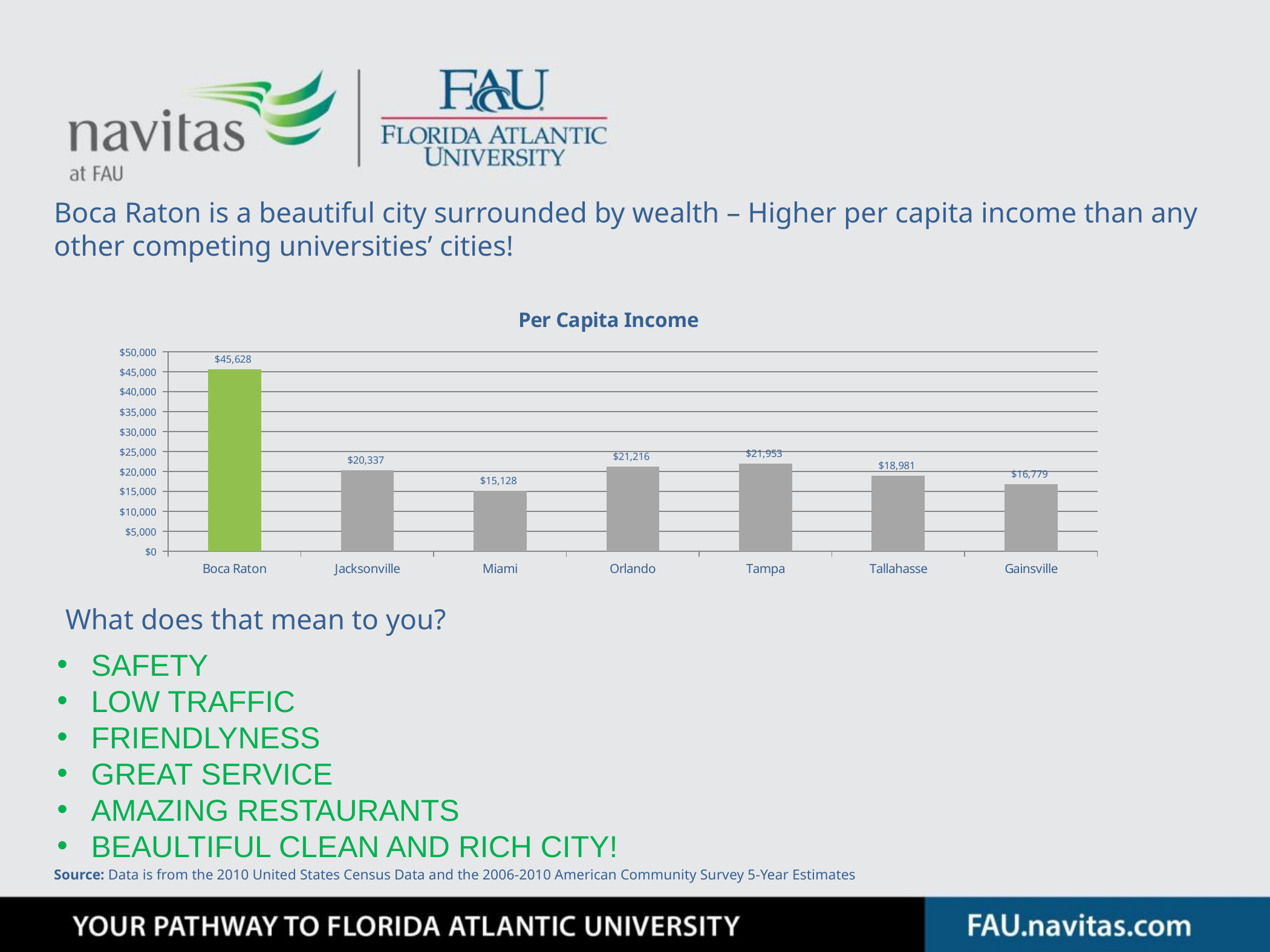
What is the per capita income shown for Miami? $15,128 Which city has the lowest per capita income in the chart? Miami How many cities are shown in the Per Capita Income chart? 7 Which bar in the chart is coloured green rather than grey? Boca Raton Which city has the highest per capita income in the chart? Boca Raton What type of chart is used to show Per Capita Income? bar chart What is the difference in per capita income between Boca Raton and Jacksonville? $25,291 What is the per capita income shown for Tallahasse? $18,981 What is the difference in per capita income between Tallahasse and Gainsville? $2,202 Is the per capita income for Gainsville greater or less than $20,000? less What is the per capita income shown for Boca Raton? $45,628 Which has a higher per capita income, Tampa or Orlando? Tampa